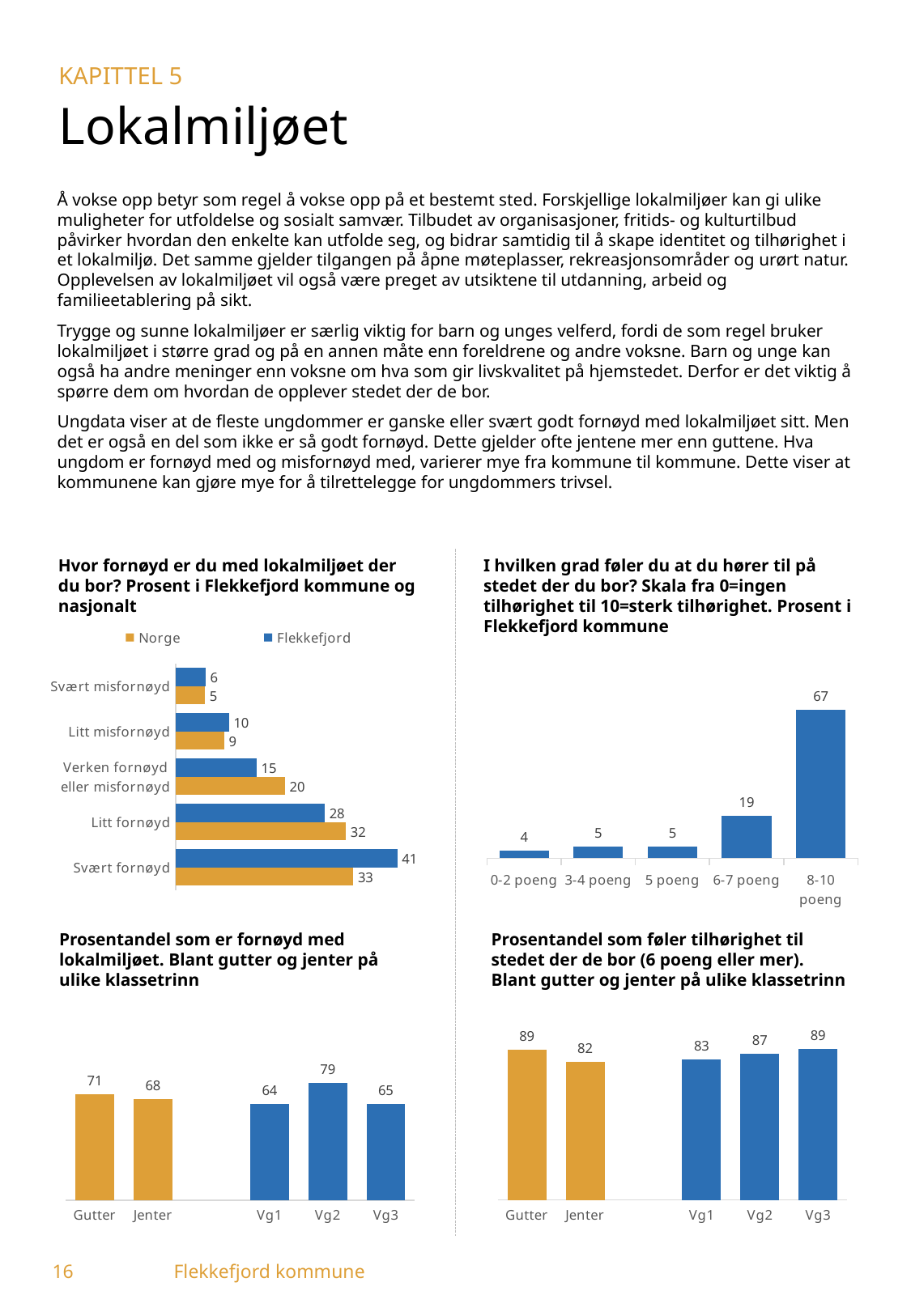
In the bottom-right chart 'Prosentandel som føler tilhørighet til stedet der de bor', do the values rise or fall from Vg1 to Vg3? rise In the bottom-left chart 'Prosentandel som er fornøyd med lokalmiljøet', what is the value for Vg2? 79 In the top-right chart 'I hvilken grad føler du at du hører til på stedet der du bor?', how many categories are shown? 5 In the top-right chart 'I hvilken grad føler du at du hører til på stedet der du bor?', which category has the highest value? 8-10 poeng In the top-left chart 'Hvor fornøyd er du med lokalmiljøet der du bor?', what is the difference between the Norge and Flekkefjord values for 'Verken fornøyd eller misfornøyd'? 5 In the bottom-right chart 'Prosentandel som føler tilhørighet til stedet der de bor', what is the difference between Gutter and Jenter? 7 In the top-left chart 'Hvor fornøyd er du med lokalmiljøet der du bor?', which is larger for 'Litt fornøyd': Norge or Flekkefjord? Norge In the top-left chart 'Hvor fornøyd er du med lokalmiljøet der du bor?', how many series does the legend list? 2 What kind of chart is the top-left chart 'Hvor fornøyd er du med lokalmiljøet der du bor?'? bar chart In the bottom-left chart 'Prosentandel som er fornøyd med lokalmiljøet', which category has the lowest value? Vg1 In the top-left chart 'Hvor fornøyd er du med lokalmiljøet der du bor?', what is the value for Flekkefjord in the 'Svært fornøyd' category? 41 In the top-right chart 'I hvilken grad føler du at du hører til på stedet der du bor?', what is the value for '6-7 poeng'? 19